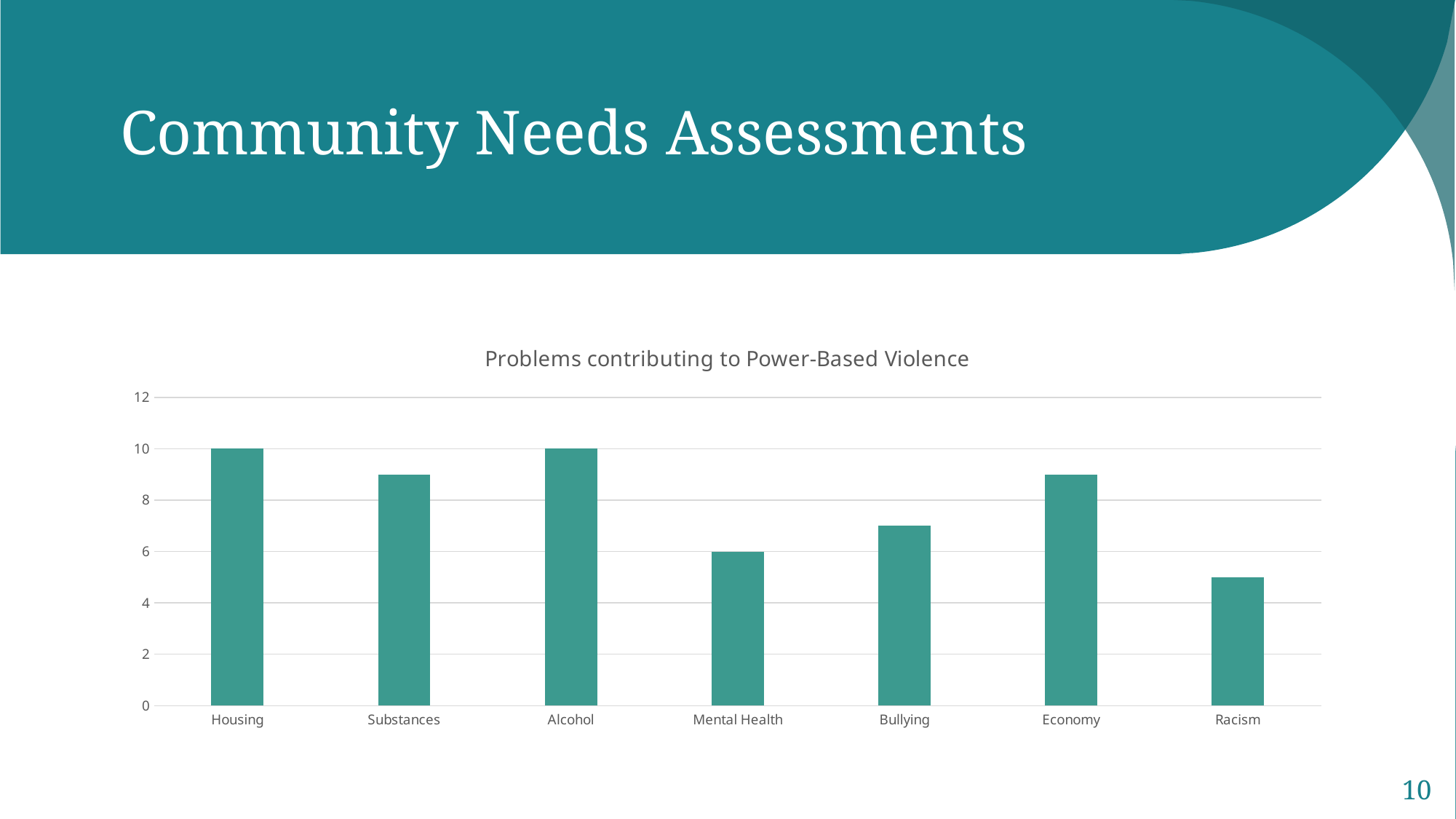
Is the value for Bullying greater or less than 6? greater Which category has the lowest value? Racism What is the value for Alcohol? 10 What is the value for Mental Health? 6 What is the value for Housing? 10 Is the value for Substances greater or less than 8? greater Which is larger, the value for Economy or the value for Racism? Economy What is the difference between the values for Housing and Mental Health? 4 What kind of chart is shown on the slide? Bar chart Is the value for Racism greater or less than 6? less Which is larger, the value for Bullying or the value for Mental Health? Bullying How many categories are shown on the x axis? 7